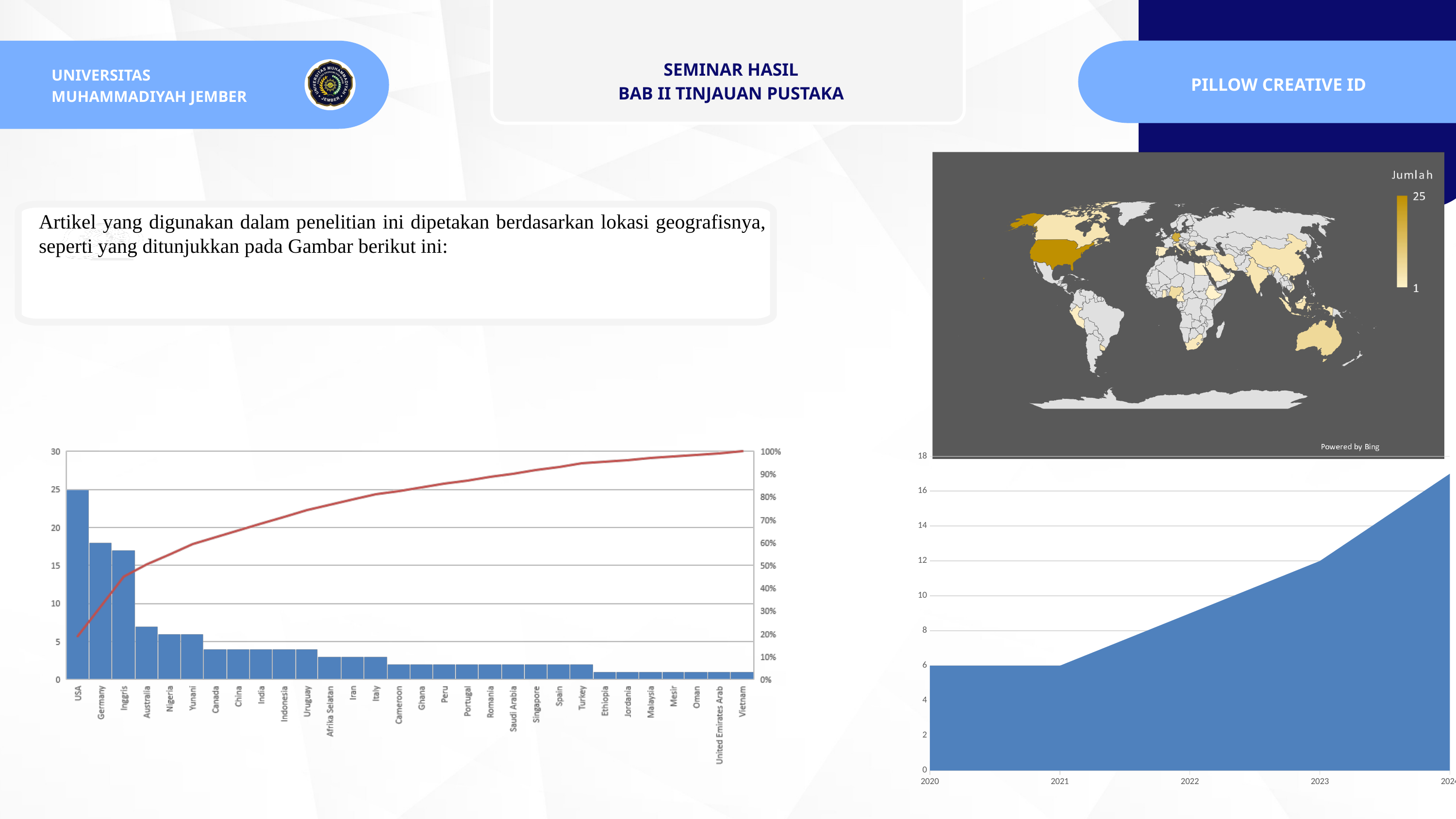
In the bottom-left chart, does the red cumulative line rise or fall from left to right? rise In the bottom-left bar chart, how many countries are shown on the x axis? 30 In the bottom-right area chart, is the value for 2024 greater or less than 16? greater In the bottom-left bar chart, what is the value for USA? 25 In the map chart at the top right, what is the maximum value shown on the 'Jumlah' legend scale? 25 In the bottom-right area chart, which year has the highest value? 2024 In the bottom-left bar chart, which is larger, the value for Inggris or the value for Australia? Inggris In the bottom-left bar chart, is the value for Australia greater or less than 10? less In the bottom-right area chart, do the values rise or fall from 2021 to 2024? rise In the bottom-left bar chart, is the value for Germany greater or less than 15? greater In the bottom-left bar chart, which country has the highest value? USA In the bottom-right area chart, what is the value for 2020? 6